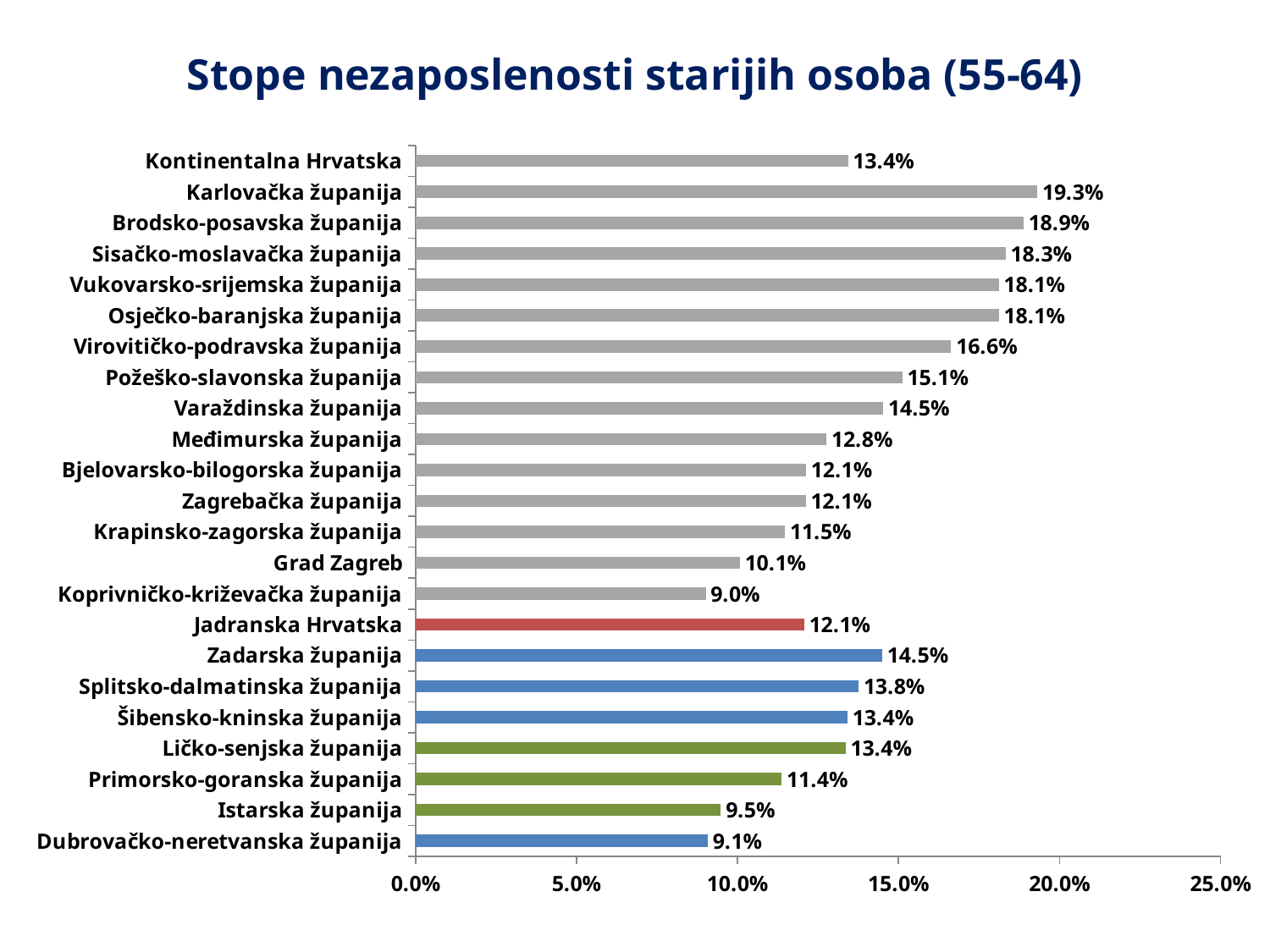
Which category has the highest value? Karlovačka županija What is the title of the chart? Stope nezaposlenosti starijih osoba (55-64) What is the difference between the values for Kontinentalna Hrvatska and Jadranska Hrvatska? 1.3% How many categories are shown in the chart? 23 What is the value for Karlovačka županija? 19.3% Which is larger, the value for Zadarska županija or the value for Primorsko-goranska županija? Zadarska županija What is the value for Jadranska Hrvatska? 12.1% What is the difference between the values for Karlovačka županija and Koprivničko-križevačka županija? 10.3% What is the value for Istarska županija? 9.5% What is the value for Grad Zagreb? 10.1% What kind of chart is shown on the slide? bar chart Which category has the lowest value? Koprivničko-križevačka županija